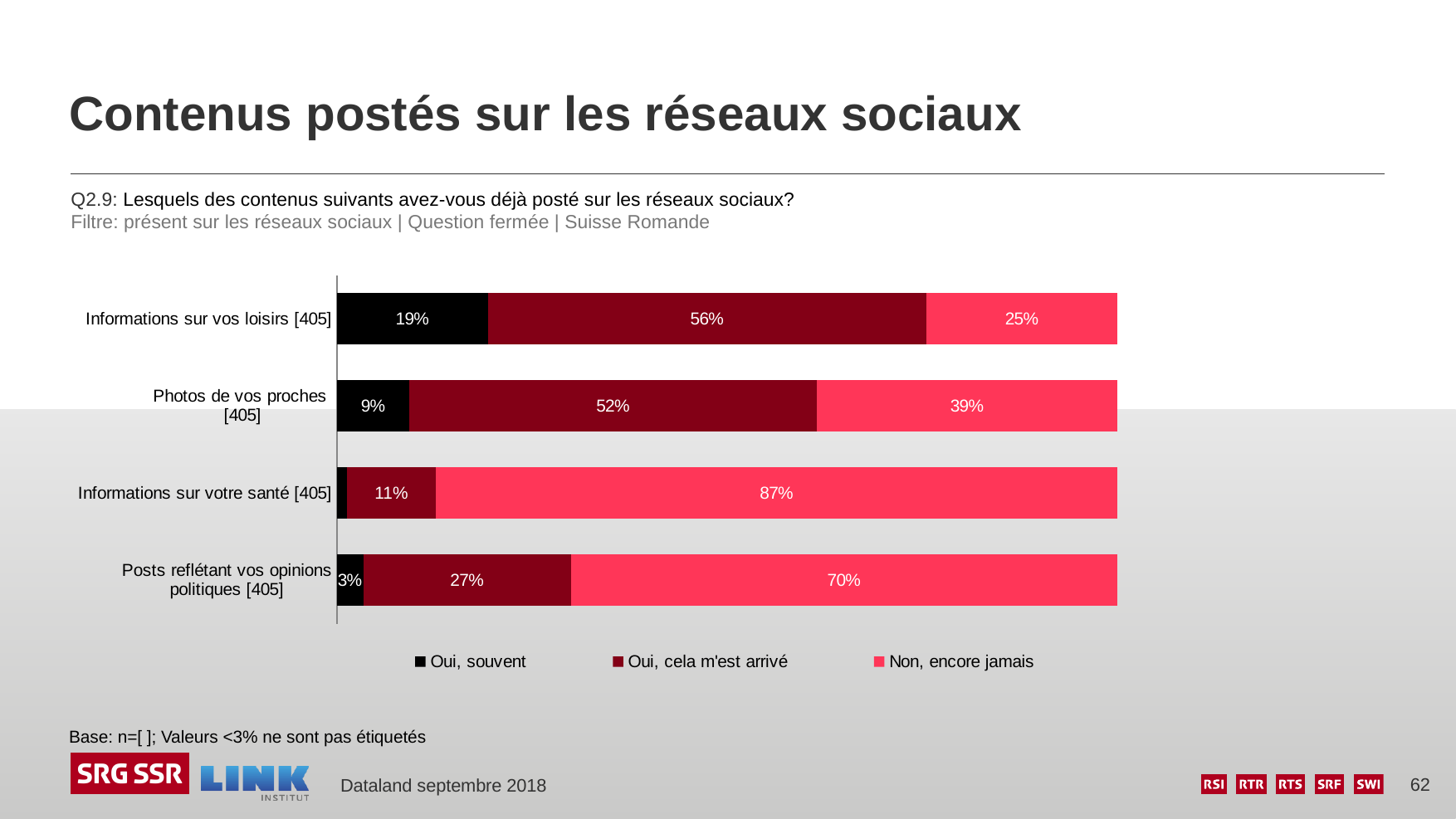
Which legend entry is shown in black? Oui, souvent What is the value of 'Non, encore jamais' for 'Informations sur votre santé'? 87% What is the value of 'Oui, souvent' for 'Informations sur vos loisirs'? 19% How many categories are shown on the chart? 4 What type of chart is shown on the slide? stacked bar chart What is the total of the stacked bar for 'Informations sur vos loisirs'? 100% Which category has the highest value for 'Non, encore jamais'? Informations sur votre santé What is the difference between the 'Non, encore jamais' values for 'Posts reflétant vos opinions politiques' and 'Informations sur vos loisirs'? 45% Which category has the lowest value for 'Oui, cela m'est arrivé'? Informations sur votre santé Which is larger: the 'Oui, souvent' value for 'Photos de vos proches' or for 'Posts reflétant vos opinions politiques'? Photos de vos proches How many series does the legend list? 3 What is the value of 'Oui, cela m'est arrivé' for 'Photos de vos proches'? 52%